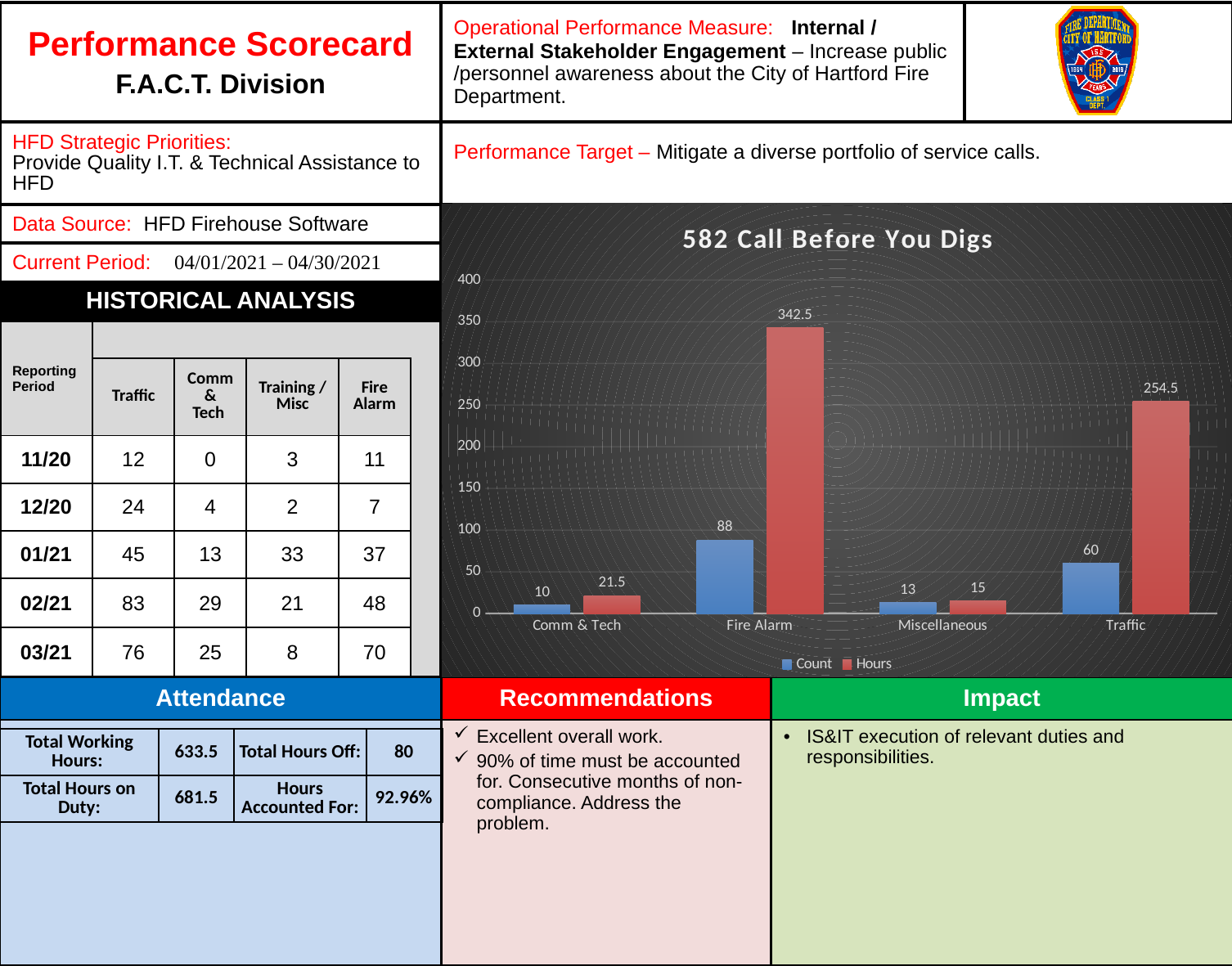
What is the Count value for Miscellaneous in the chart? 13 Which category has the highest Hours value in the chart? Fire Alarm What is the Hours value for Traffic in the chart? 254.5 What kind of chart is shown on the slide? Bar chart Which category has the lowest Count value in the chart? Comm & Tech How many series does the chart legend list? 2 What is the difference between the Hours values for Fire Alarm and Traffic? 88 What is the title of the chart? 582 Call Before You Digs What is the Count value for Fire Alarm in the chart? 88 What is the Hours value for Comm & Tech in the chart? 21.5 How many categories are shown on the x axis of the chart? 4 Which is larger: the Count for Traffic or the Count for Fire Alarm? Fire Alarm